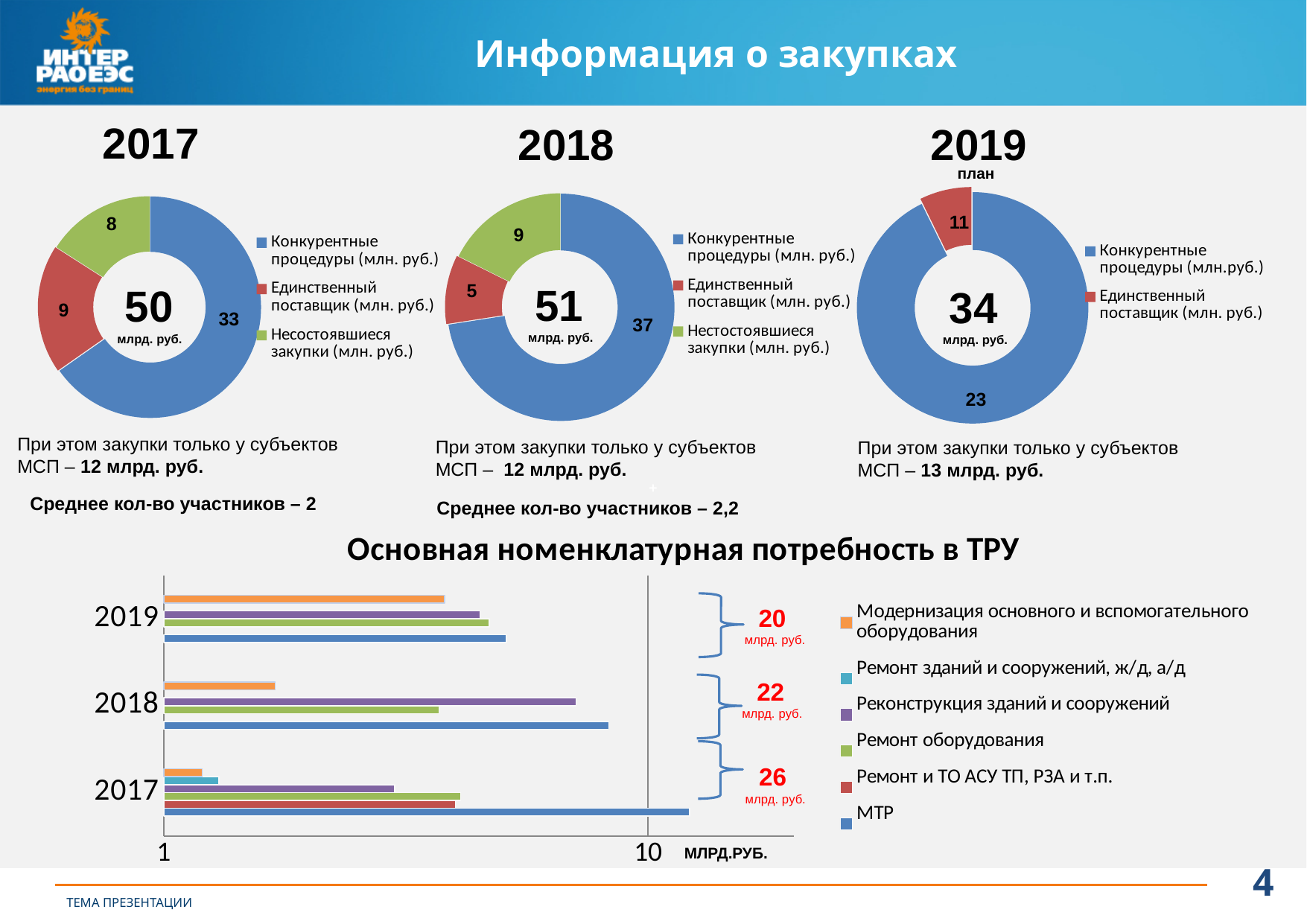
In the 2018 donut chart, what is the value for Единственный поставщик? 5 How many categories does the legend of the 2019 план donut chart list? 2 In the 2018 donut chart, what is the difference between Конкурентные процедуры and Несостоявшиеся закупки? 28 How many series does the legend of the 'Основная номенклатурная потребность в ТРУ' chart list? 6 In the 2018 donut chart, which category has the smallest value? Единственный поставщик What kind of chart is 'Основная номенклатурная потребность в ТРУ'? bar chart In the 2019 план donut chart, what is the value for Единственный поставщик? 11 In the 'Основная номенклатурная потребность в ТРУ' chart, what total is shown for 2017? 26 млрд. руб. In the 2017 donut chart, which category has the largest value? Конкурентные процедуры What total is shown in the centre of the 2017 donut chart? 50 млрд. руб. In the 'Основная номенклатурная потребность в ТРУ' chart, which series has the longest bar for 2017? МТР In the 2017 donut chart, what is the value for Конкурентные процедуры? 33